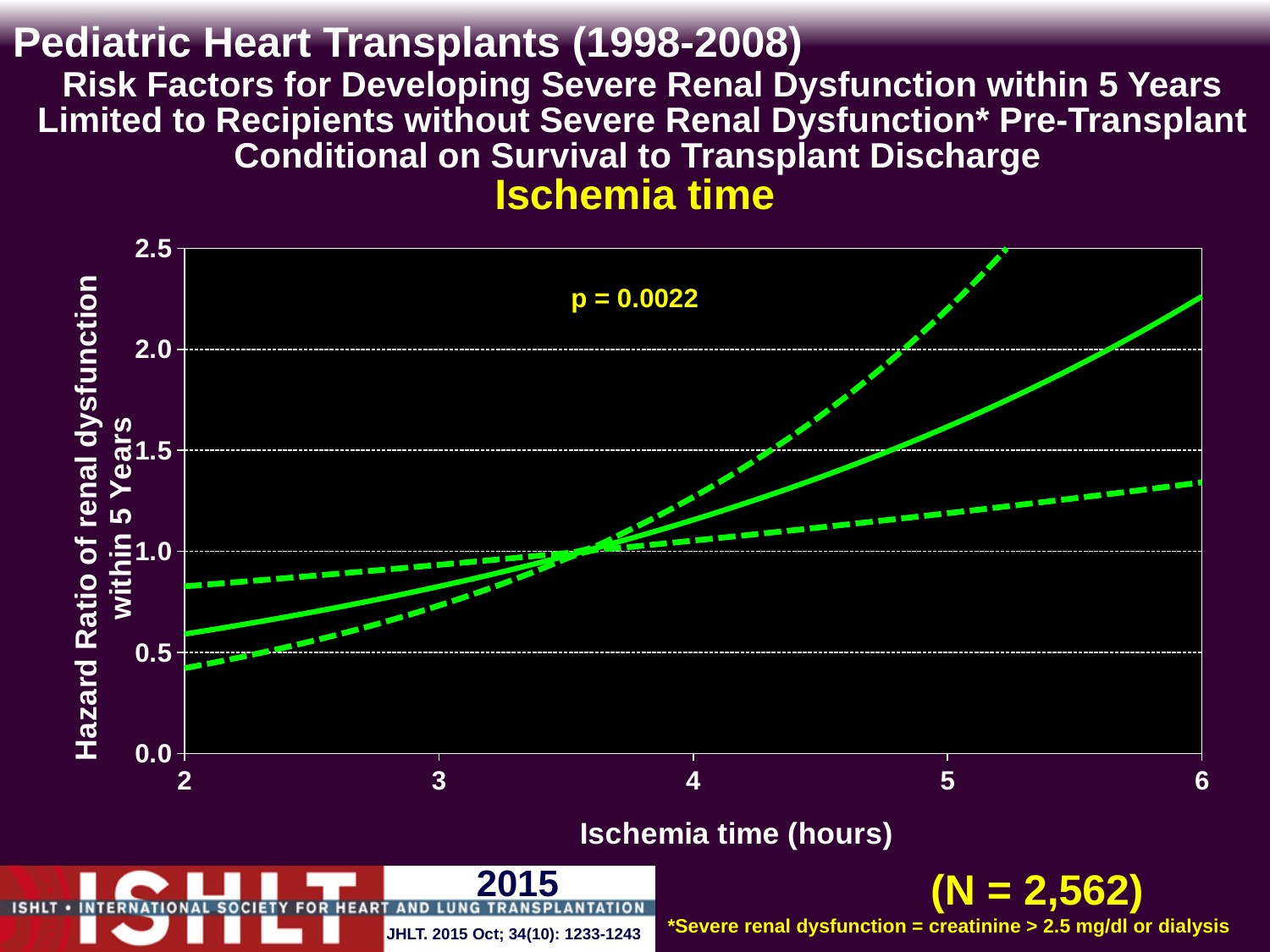
What is the label of the x axis? Ischemia time (hours) Is the lower dashed line at an ischemia time of 2 hours greater or less than 0.5? less What is the p-value printed on the chart? p = 0.0022 Is the hazard ratio on the solid line at an ischemia time of 2 hours greater or less than 1.0? less Does the solid hazard ratio line rise or fall as ischemia time increases from 2 to 6 hours? rise How many lines are plotted on the chart? 3 Is the upper dashed line at an ischemia time of 5 hours greater or less than 2.0? greater What kind of chart is shown on the slide? line chart At an ischemia time of 6 hours, which is larger: the solid line or the lower dashed line? the solid line